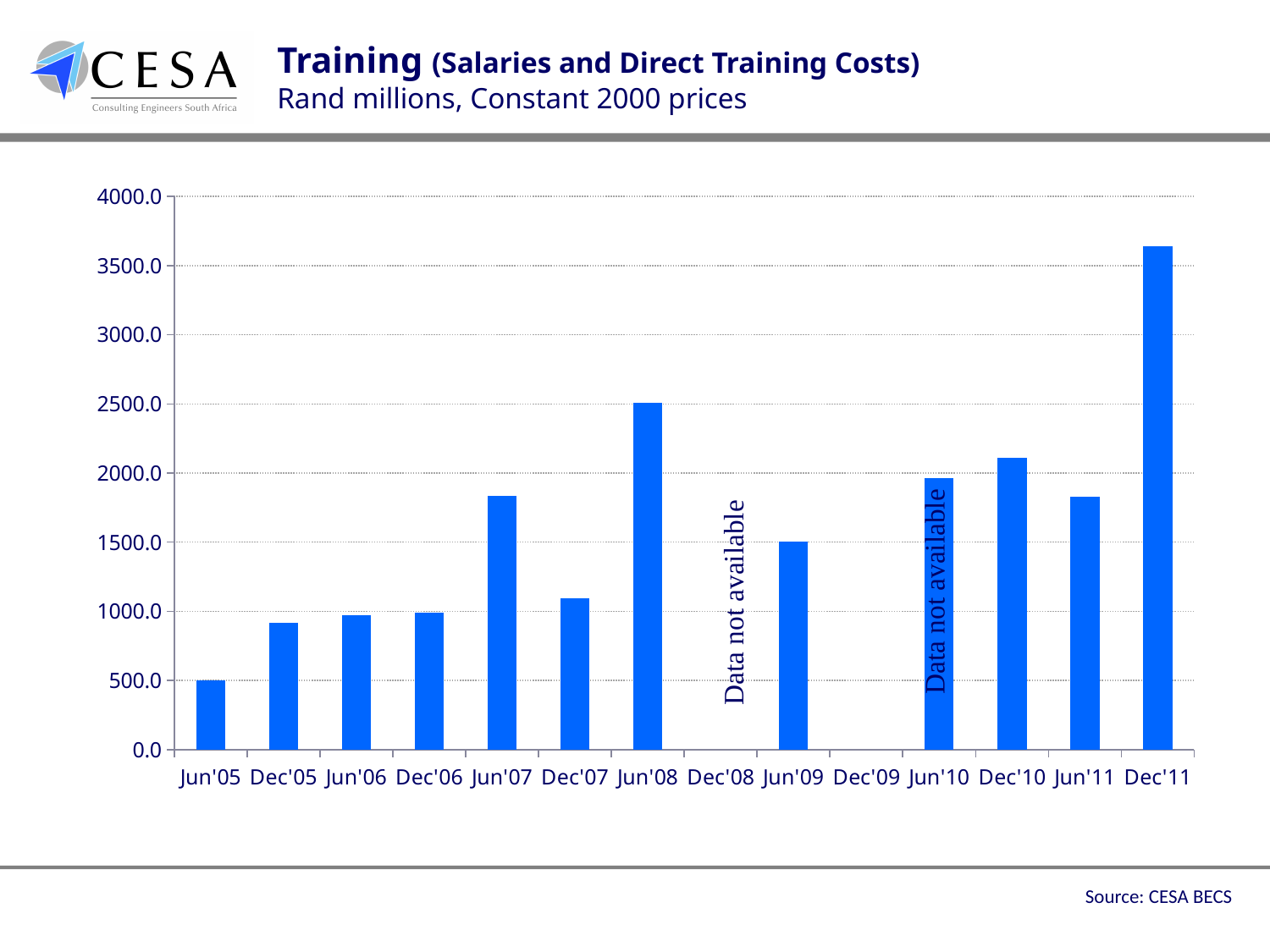
What kind of chart is shown on the slide? Bar chart Is the value for Jun'11 greater or less than 2000? less Which period has the lowest training value among those with data? Jun'05 Is the value for Jun'08 greater or less than 2000? greater Do the values rise or fall from Jun'05 to Dec'06? rise Is the value for Dec'11 greater or less than 3500? greater Which period has the highest training value? Dec'11 How many periods are labelled on the x axis? 14 For which periods is the chart marked 'Data not available'? Dec'08 and Dec'09 Which is larger, the value for Jun'08 or the value for Dec'10? Jun'08